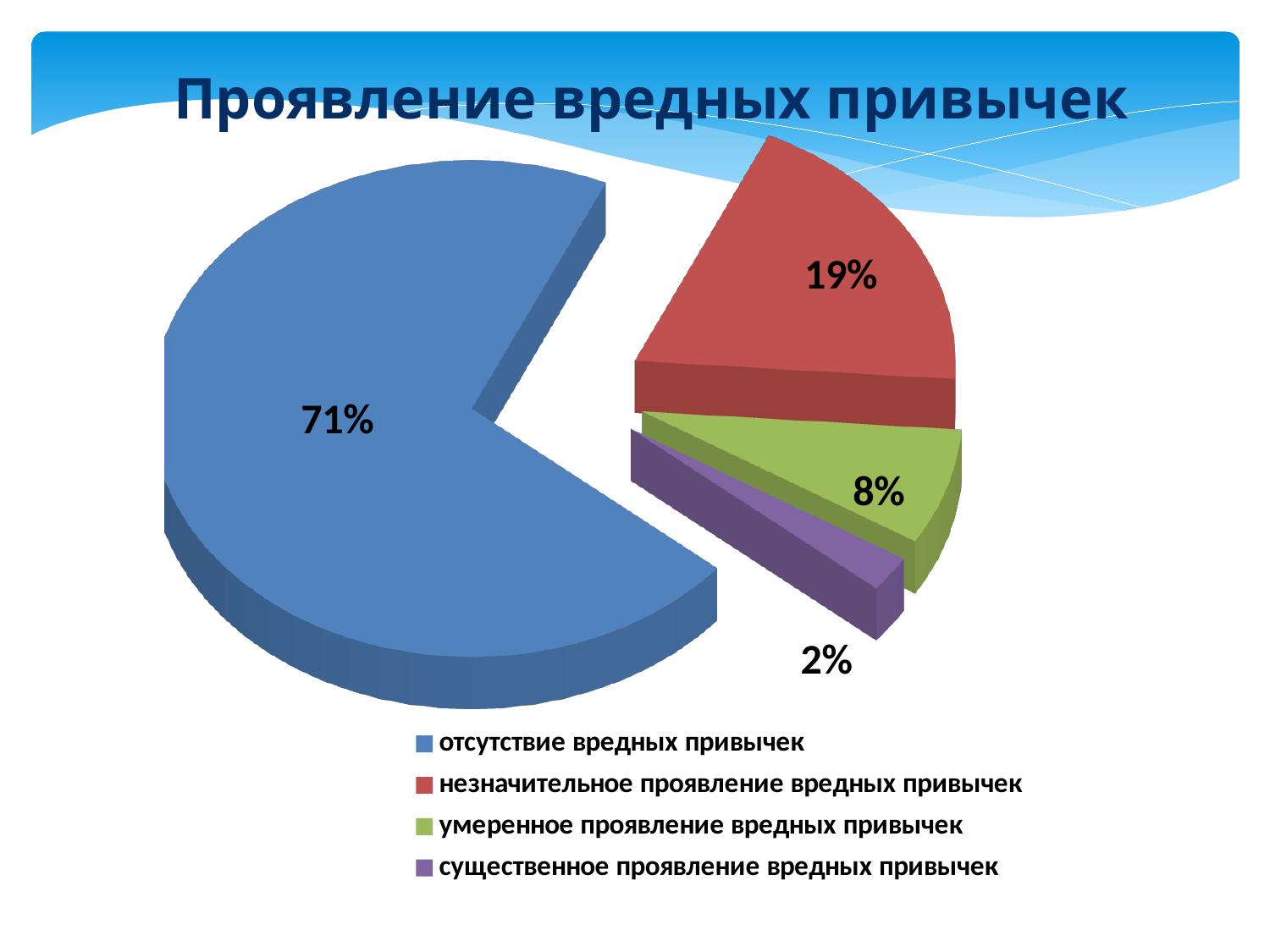
What kind of chart is shown on the slide? Pie chart Which category has the largest slice of the pie? отсутствие вредных привычек Which category has the smallest slice of the pie? существенное проявление вредных привычек What is the difference in percentage points between "незначительное проявление вредных привычек" and "умеренное проявление вредных привычек"? 11 What share of the pie does "существенное проявление вредных привычек" have? 2% How many slices does the pie chart have? 4 What share of the pie does "отсутствие вредных привычек" have? 71% What share of the pie does "умеренное проявление вредных привычек" have? 8% What share of the pie does "незначительное проявление вредных привычек" have? 19% What colour is the slice for "незначительное проявление вредных привычек"? Red What is the title of the chart? Проявление вредных привычек Which is larger: the slice for "умеренное проявление вредных привычек" or the slice for "существенное проявление вредных привычек"? умеренное проявление вредных привычек